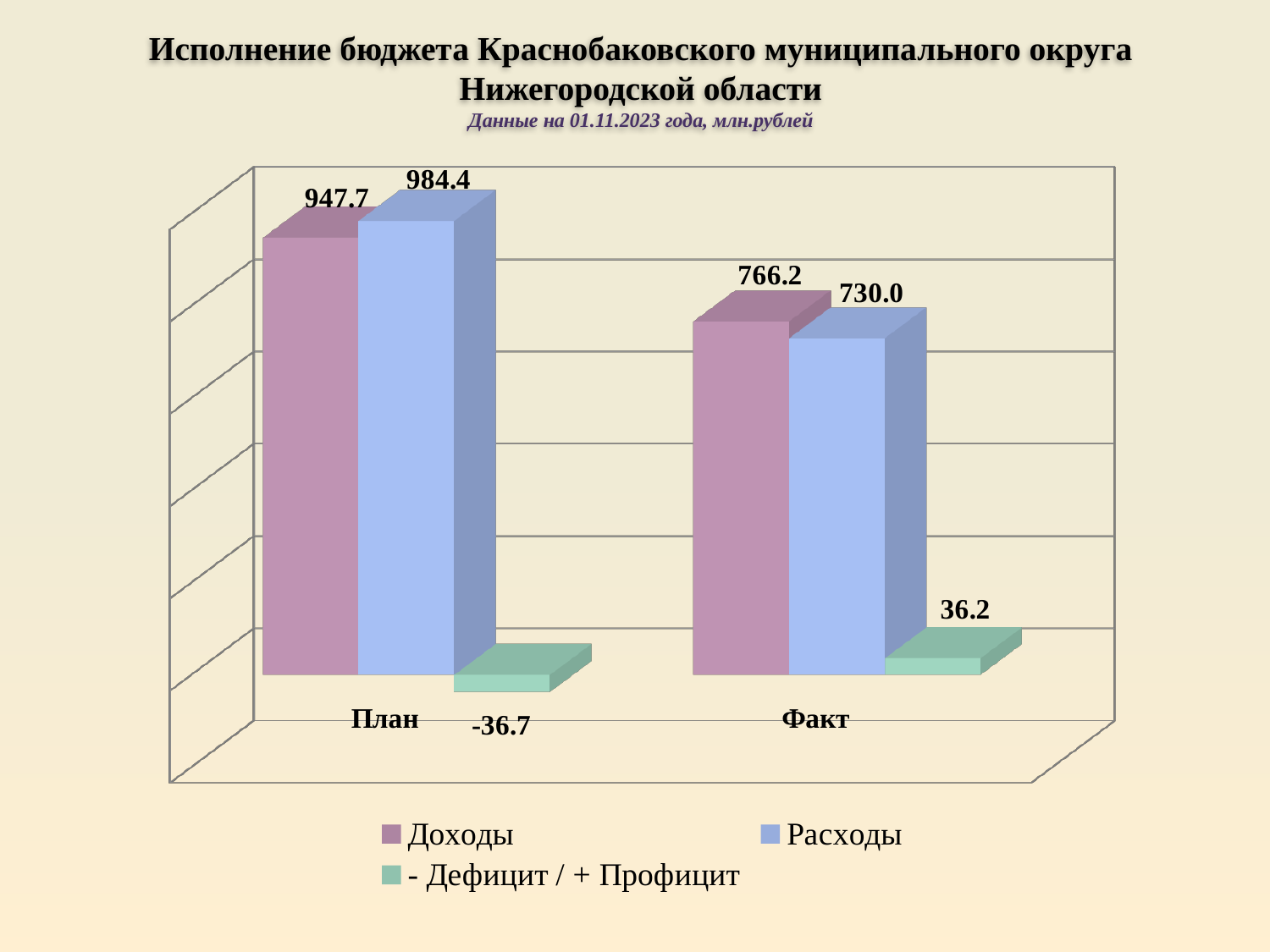
What type of chart is shown on the slide? Bar chart Which bar has the highest value on the chart? Расходы for План (984.4) What is the value of the '- Дефицит / + Профицит' series for План? -36.7 What is the difference between Расходы and Доходы for План? 36.7 What is the value of Расходы for Факт? 730.0 What is the value of Доходы for План? 947.7 What is the difference between Доходы for План and Доходы for Факт? 181.5 Which category has the higher value for Расходы, План or Факт? План How many categories are shown on the x axis? 2 How many series does the legend list? 3 For Факт, which is larger: Доходы or Расходы? Доходы What is the value of the '- Дефицит / + Профицит' series for Факт? 36.2